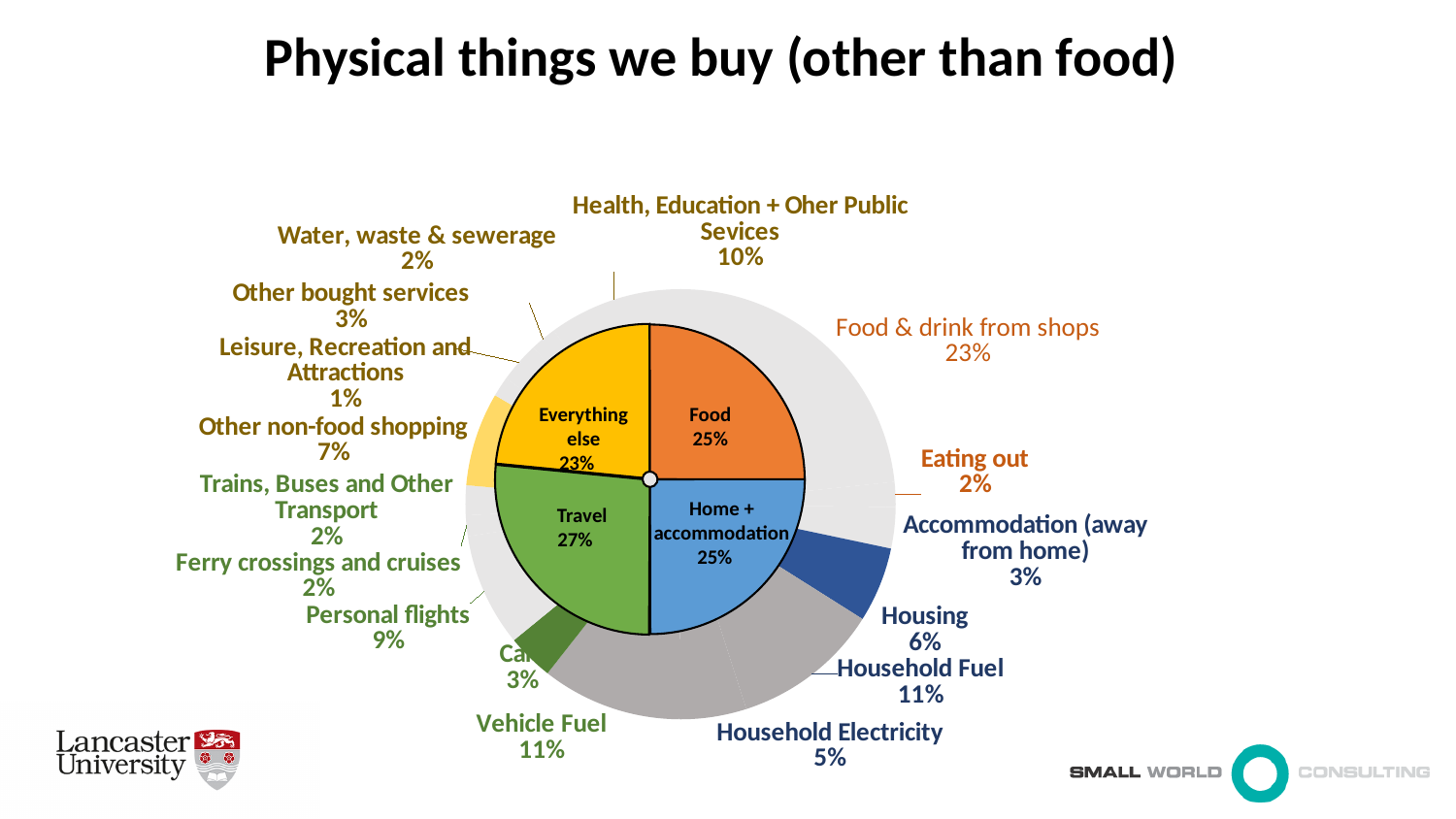
What percentage is shown for Food & drink from shops? 23% Which is larger, the share for Housing or the share for Accommodation (away from home)? Housing What percentage is shown for Other non-food shopping? 7% What kind of chart is shown on the slide? pie chart What percentage does the inner pie show for Everything else? 23% Which outer-ring category has the smallest share? Leisure, Recreation and Attractions Which inner-pie category has the smallest share? Everything else What percentage does the inner pie show for Travel? 27% Which inner-pie category has the largest share? Travel What is the difference between the Household Fuel share and the Household Electricity share? 6% What percentage is shown for Personal flights? 9% What is the title of the slide? Physical things we buy (other than food)